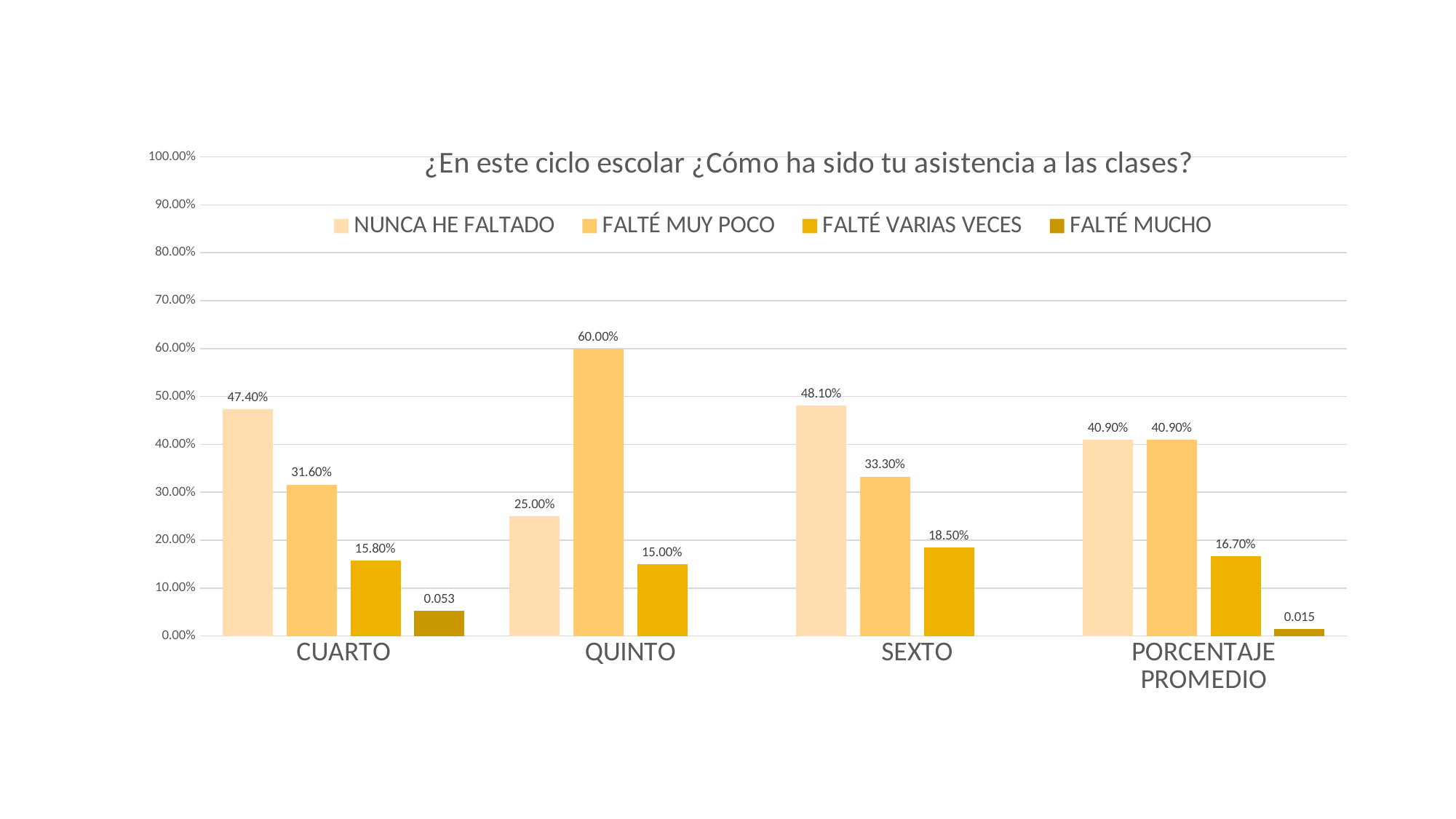
What is the value for FALTÉ MUY POCO in the QUINTO category? 60.00% What is the value for NUNCA HE FALTADO in the CUARTO category? 47.40% What is the value for FALTÉ VARIAS VECES in the SEXTO category? 18.50% In the SEXTO category, which is larger: NUNCA HE FALTADO or FALTÉ MUY POCO? NUNCA HE FALTADO What kind of chart is shown on the slide? bar chart Which category has the highest value for FALTÉ MUY POCO? QUINTO Is the value for FALTÉ MUY POCO in the QUINTO category greater or less than 50.00%? greater Which category has the lowest value for NUNCA HE FALTADO? QUINTO In the QUINTO category, what is the difference between FALTÉ MUY POCO and NUNCA HE FALTADO? 35.00% What is the value for FALTÉ MUCHO in the PORCENTAJE PROMEDIO category? 0.015 How many series does the legend list? 4 How many categories are shown on the x axis? 4